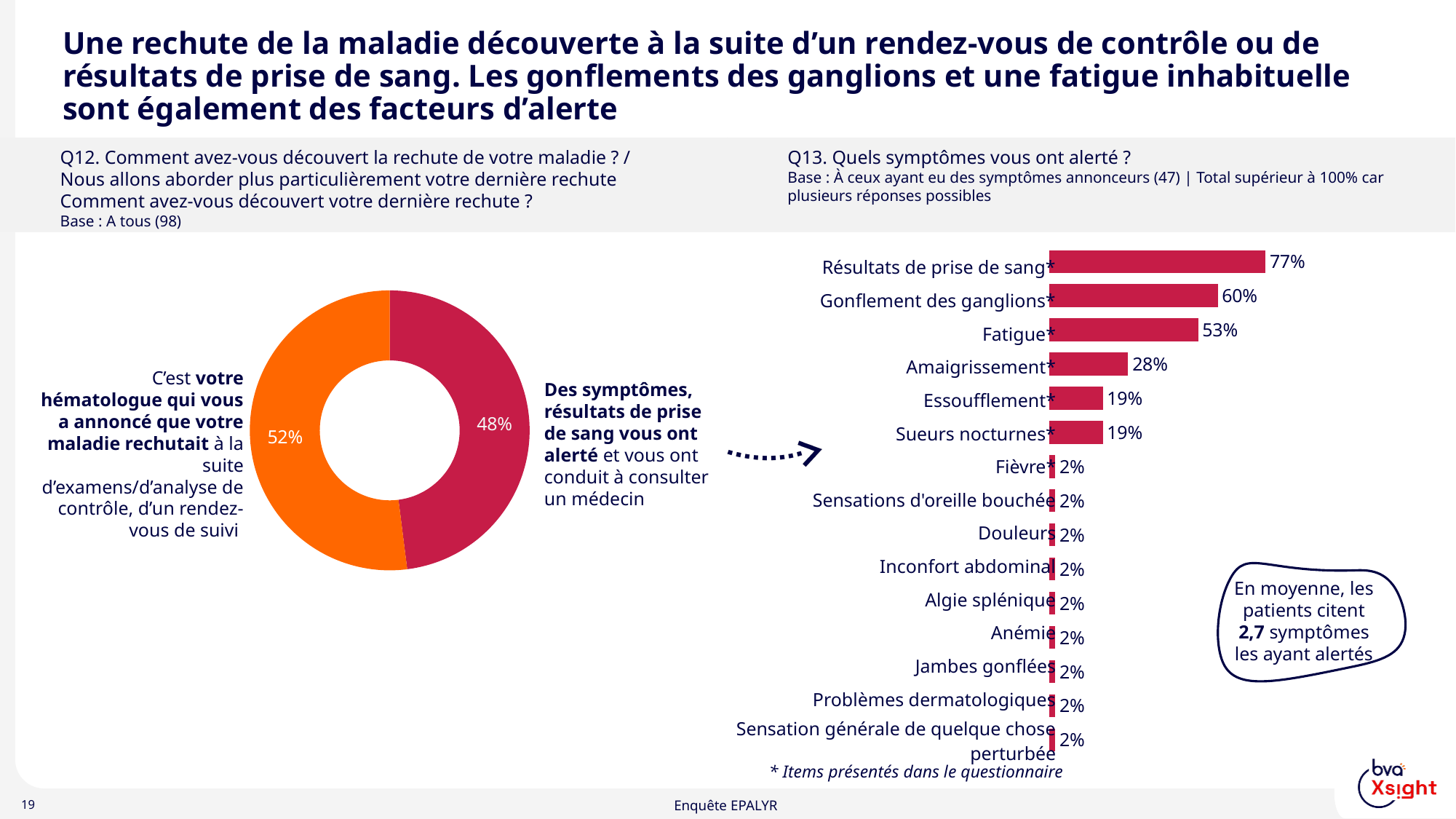
In the Q12 donut chart on the left, what share of respondents said symptoms or blood test results alerted them? 48% In the Q13 bar chart on the right, what percentage is shown for 'Résultats de prise de sang'? 77% In the Q12 donut chart on the left, which colour represents the 52% segment? Orange In the Q13 bar chart on the right, which is larger: the value for 'Essoufflement' or the value for 'Amaigrissement'? Amaigrissement In the Q13 bar chart on the right, what percentage is shown for 'Amaigrissement'? 28% In the Q12 donut chart on the left, what share of respondents said their hematologist announced the relapse? 52% How many symptom categories are listed in the Q13 bar chart on the right? 15 In the Q13 bar chart on the right, what percentage is shown for 'Sueurs nocturnes'? 19% What type of chart is used for Q13 on the right side of the slide? Bar chart In the Q13 bar chart on the right, what is the difference in percentage points between 'Gonflement des ganglions' and 'Fatigue'? 7 percentage points In the Q13 bar chart on the right, which symptom has the highest percentage? Résultats de prise de sang What type of chart is used for Q12 on the left side of the slide? Donut (pie) chart